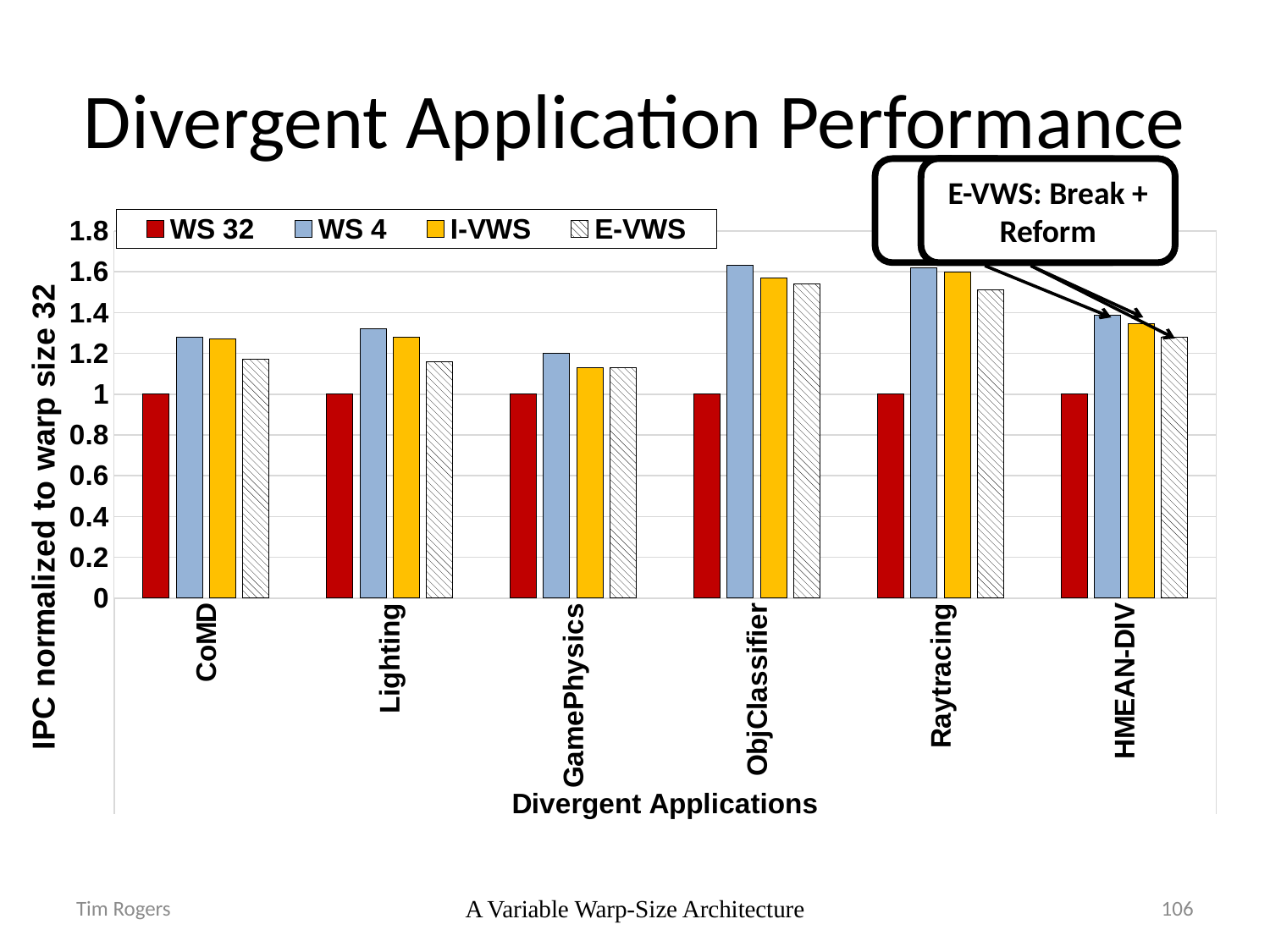
Which application has the lowest WS 4 value? GamePhysics Is the I-VWS value for GamePhysics greater or less than 1.2? less How many application categories are shown on the x axis? 6 For ObjClassifier, which is larger: the WS 4 value or the E-VWS value? WS 4 What is the title of the chart's y axis? IPC normalized to warp size 32 What is the value of the WS 32 bar for CoMD? 1 Is the WS 4 value for ObjClassifier greater or less than 1.4? greater How many series does the legend list? 4 Is the WS 4 value for Lighting greater or less than 1.2? greater What kind of chart is shown on the slide? bar chart What text is in the callout box pointing at the HMEAN-DIV bars? E-VWS: Break + Reform